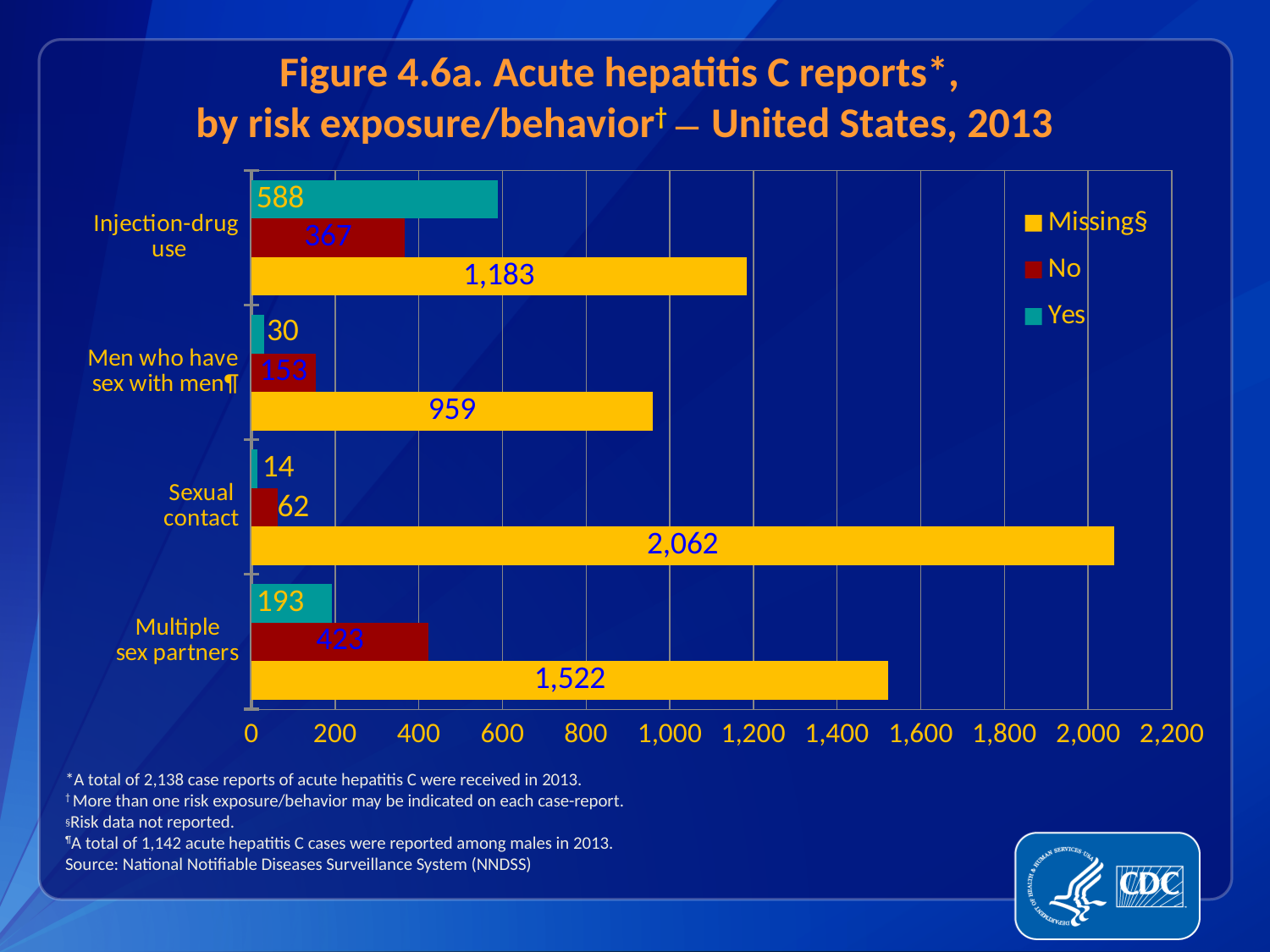
Which category has the lowest Yes value? Sexual contact What is the value of the Yes series for Injection-drug use? 588 What is the difference between the Missing§ values for Sexual contact and Injection-drug use? 879 Which category has the highest Missing§ value? Sexual contact What is the value of the Missing§ series for Multiple sex partners? 1,522 How many risk exposure/behavior categories are shown on the chart? 4 What is the value of the Missing§ series for Sexual contact? 2,062 Which series is shown in yellow in the legend? Missing§ What is the value of the Yes series for Men who have sex with men¶? 30 Which is larger: the Yes value for Multiple sex partners or the Yes value for Injection-drug use? Injection-drug use What type of chart is shown on the slide? bar chart How many series does the legend list? 3